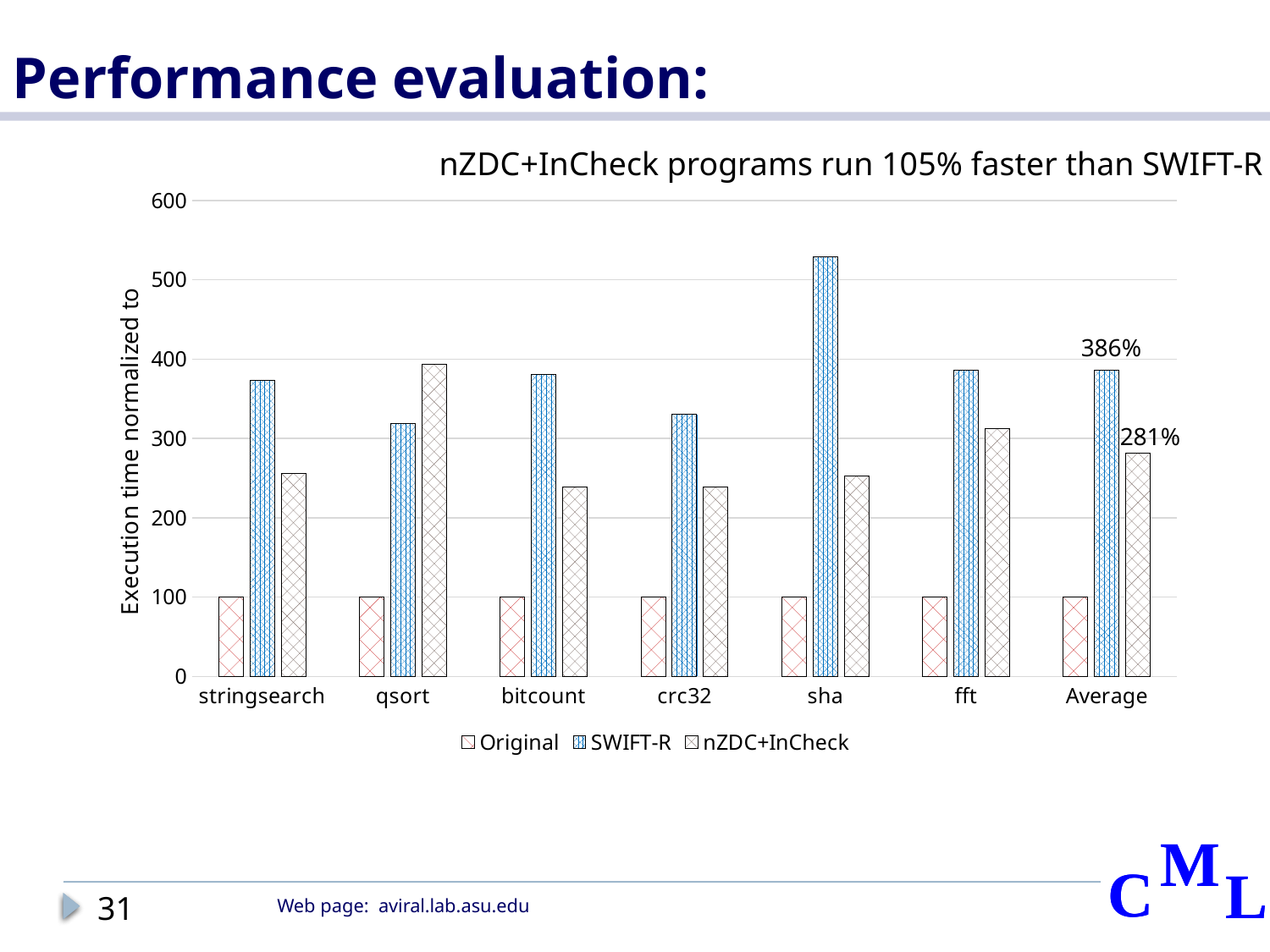
What is the nZDC+InCheck value for Average? 281% What is the title of the chart? nZDC+InCheck programs run 105% faster than SWIFT-R Is the SWIFT-R value for sha greater or less than 500? greater What is the difference between the SWIFT-R and nZDC+InCheck values for Average? 105% Is the nZDC+InCheck value for crc32 greater or less than 300? less How many categories are shown on the x axis? 7 Which category has the highest SWIFT-R bar? sha What is the SWIFT-R value for Average? 386% How many series does the legend list? 3 What kind of chart is shown on the slide? bar chart For qsort, which is larger: SWIFT-R or nZDC+InCheck? nZDC+InCheck What is the Original value for stringsearch? 100